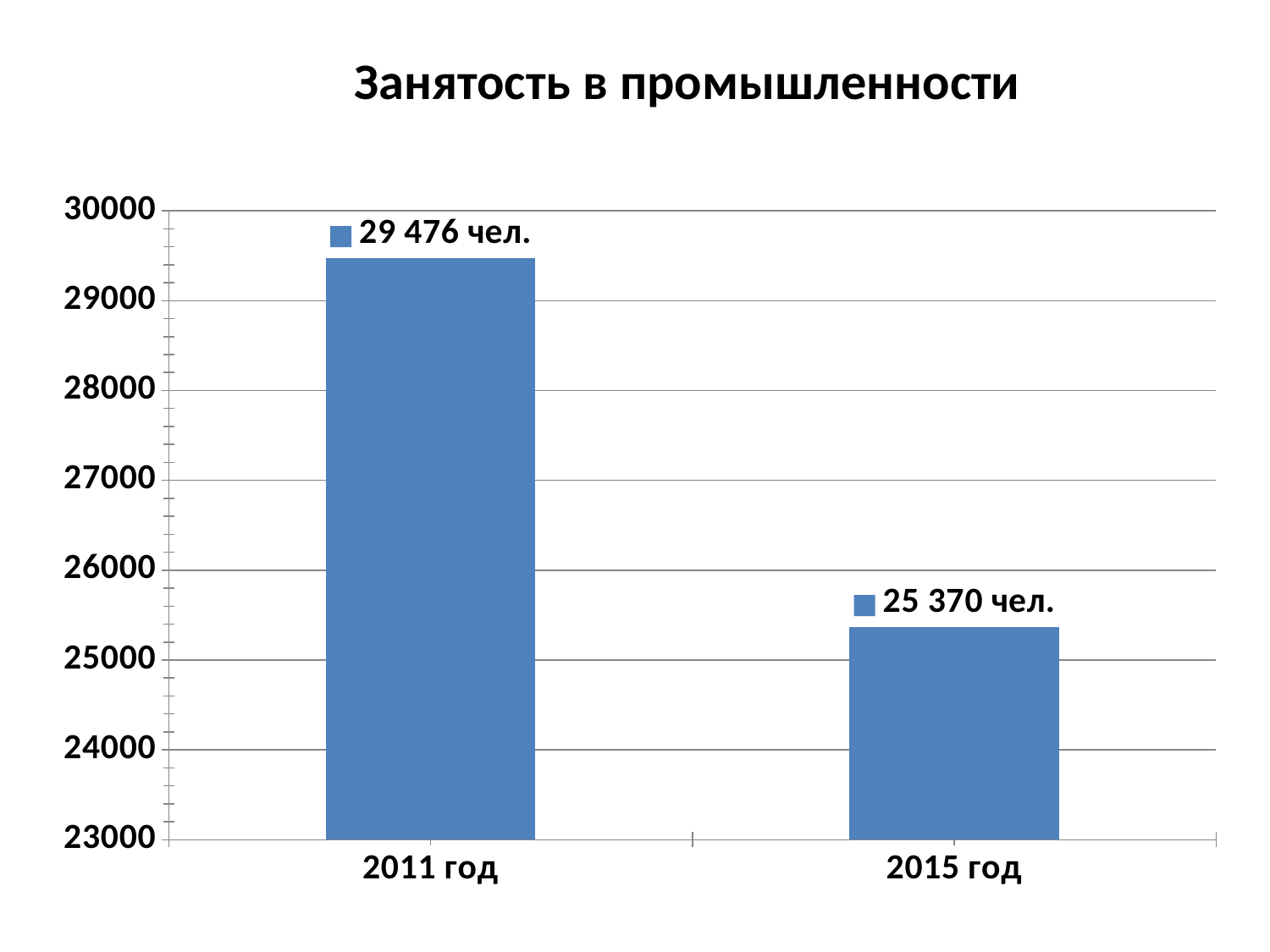
Is the value for 2011 год greater or less than 29000? greater Which is larger, the value for 2011 год or for 2015 год? 2011 год What is the difference between the values for 2011 год and 2015 год? 4 106 чел. What is the value for 2011 год? 29 476 чел. Do the values rise or fall from 2011 год to 2015 год? fall Is the value for 2015 год greater or less than 26000? less Which year has the lowest value? 2015 год What kind of chart is this? bar chart How many categories are shown on the x axis? 2 What is the value for 2015 год? 25 370 чел. Which year has the highest value? 2011 год What is the title of the chart? Занятость в промышленности